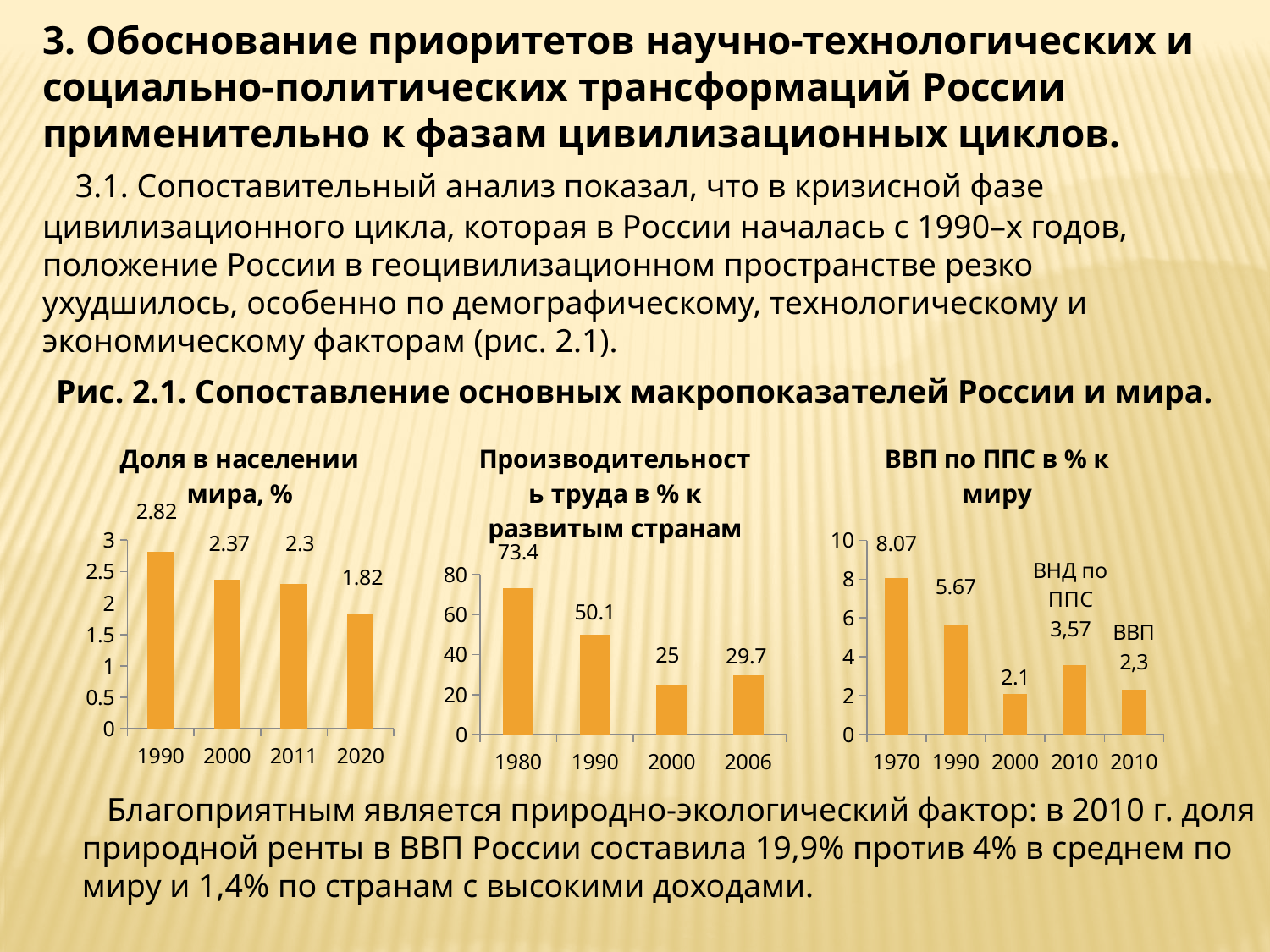
In the chart titled "Производительность труда в % к развитым странам", which year has the highest value? 1980 In the chart titled "Производительность труда в % к развитым странам", which is larger, the value for 2000 or the value for 2006? 2006 In the chart titled "Доля в населении мира, %", which year has the lowest value? 2020 In the chart titled "ВВП по ППС в % к миру", what is the value for 1970? 8.07 In the chart titled "ВВП по ППС в % к миру", what is the value for 2000? 2.1 In the chart titled "Доля в населении мира, %", what is the value for 1990? 2.82 In the chart titled "Доля в населении мира, %", how many bars are plotted? 4 In the chart titled "Производительность труда в % к развитым странам", what is the difference between the values for 1980 and 2000? 48.4 In the chart titled "ВВП по ППС в % к миру", how many bars are plotted? 5 What type of chart is the chart titled "Доля в населении мира, %"? bar chart In the chart titled "Доля в населении мира, %", do the values rise or fall from 1990 to 2020? fall In the chart titled "Производительность труда в % к развитым странам", what is the value for 1990? 50.1